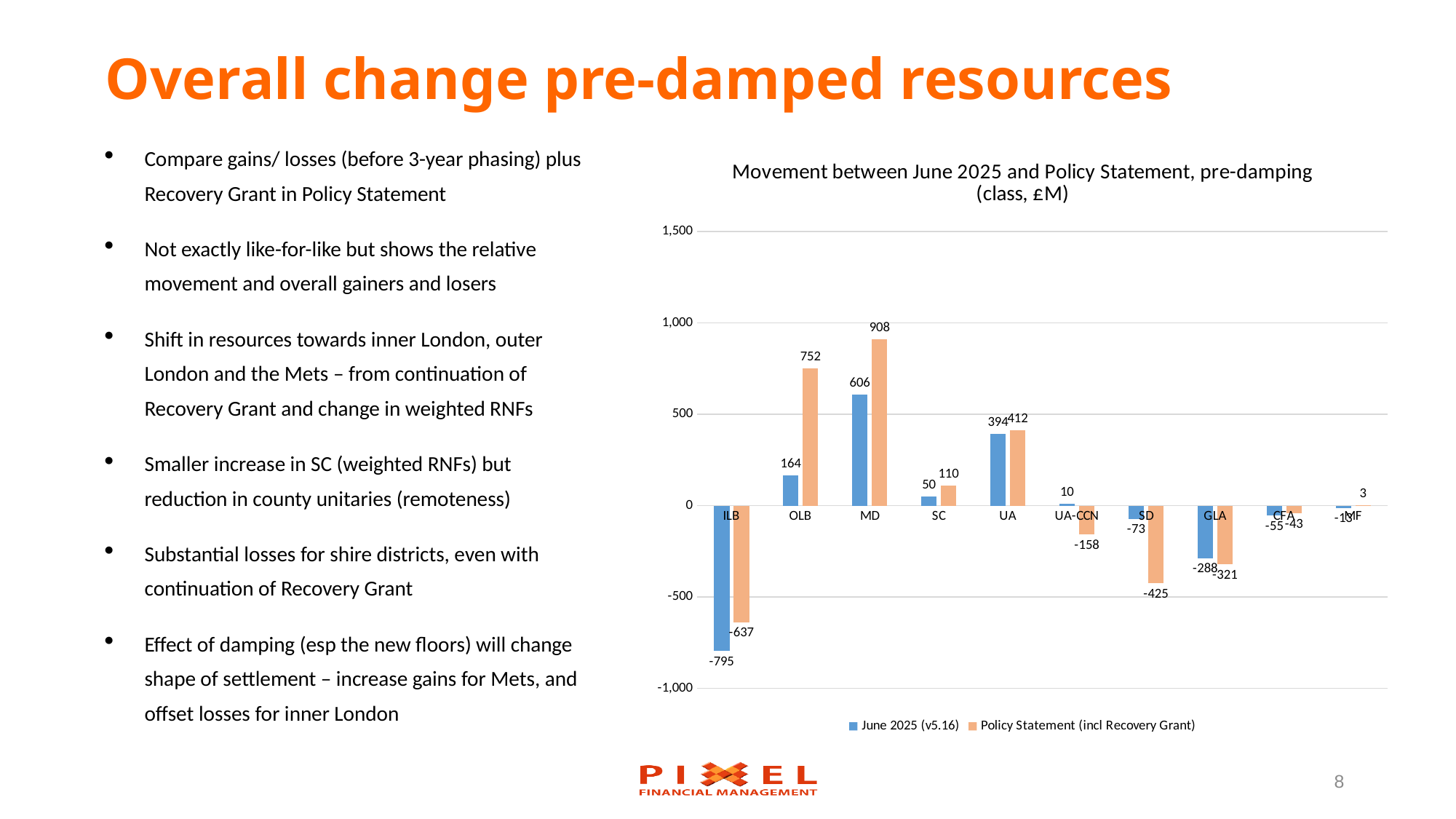
Which class has the highest Policy Statement (incl Recovery Grant) value? MD What is the title of the chart? Movement between June 2025 and Policy Statement, pre-damping (class, £M) What is the Policy Statement (incl Recovery Grant) value for MD? 908 For OLB, what is the difference between the Policy Statement (incl Recovery Grant) value and the June 2025 (v5.16) value? 588 For MD, how much higher is the Policy Statement (incl Recovery Grant) value than the June 2025 (v5.16) value? 302 How many series does the chart legend list? 2 For SD, which series has the larger value: June 2025 (v5.16) or Policy Statement (incl Recovery Grant)? June 2025 (v5.16) What is the Policy Statement (incl Recovery Grant) value for SD? -425 Which class has the lowest June 2025 (v5.16) value? ILB What kind of chart is shown on the slide? Bar chart What is the June 2025 (v5.16) value for ILB? -795 How many classes are shown on the x axis of the chart? 10